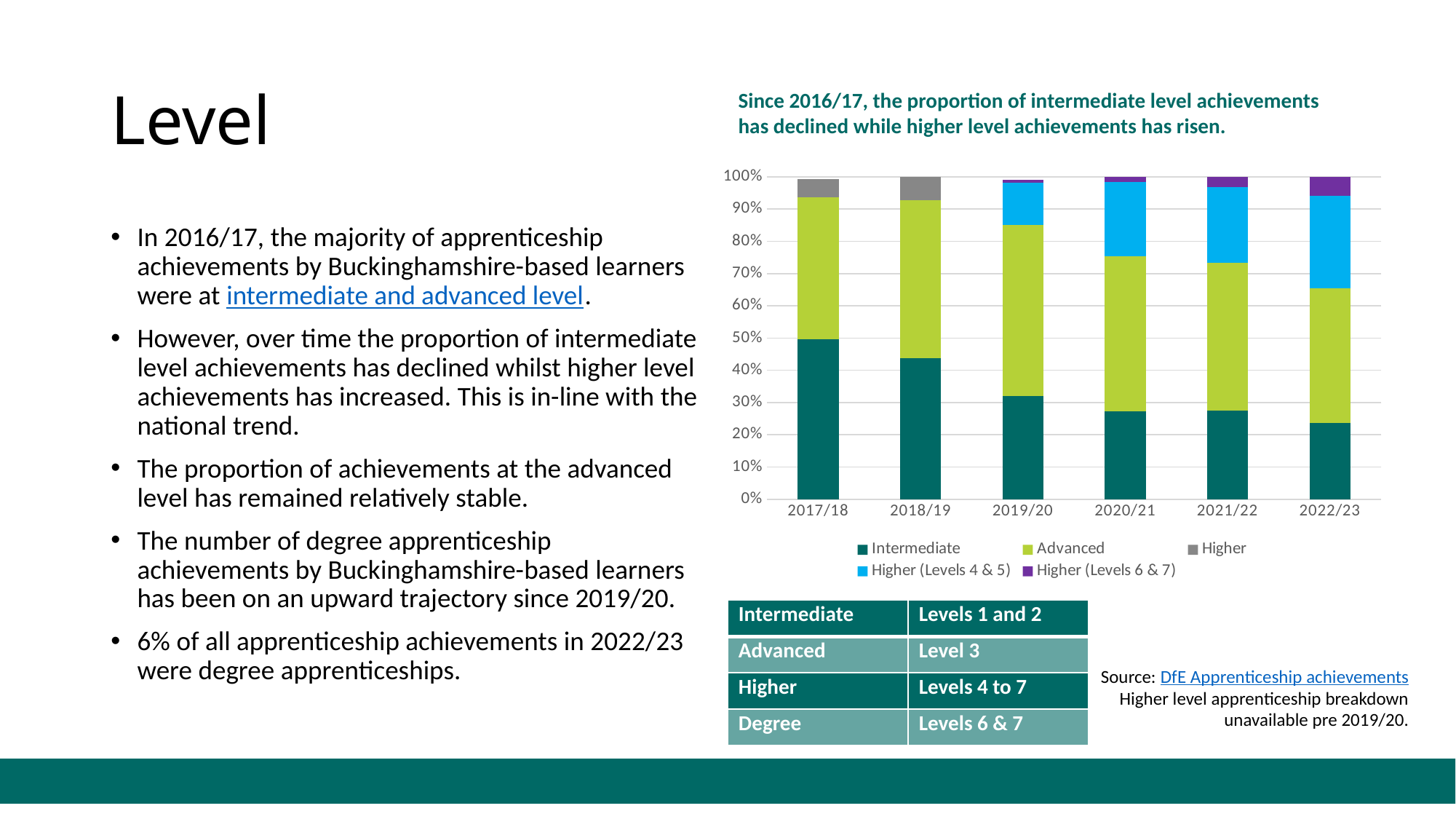
Is the Intermediate proportion for 2019/20 greater or less than 30%? greater Which is larger: the Intermediate proportion in 2017/18 or in 2022/23? 2017/18 What kind of chart is shown on the slide? Stacked bar chart Which year has the largest Higher (Levels 4 & 5) segment? 2022/23 How many academic years are shown on the x axis of the chart? 6 Is the Intermediate proportion for 2018/19 greater or less than 50%? less Does the proportion of Intermediate achievements rise or fall from 2017/18 to 2022/23? Fall How many series does the chart's legend list? 5 Which series is shown in grey in the chart's legend? Higher Which year has the highest proportion of Intermediate achievements? 2017/18 Is the Intermediate proportion for 2022/23 greater or less than 30%? less Which year has the lowest proportion of Intermediate achievements? 2022/23